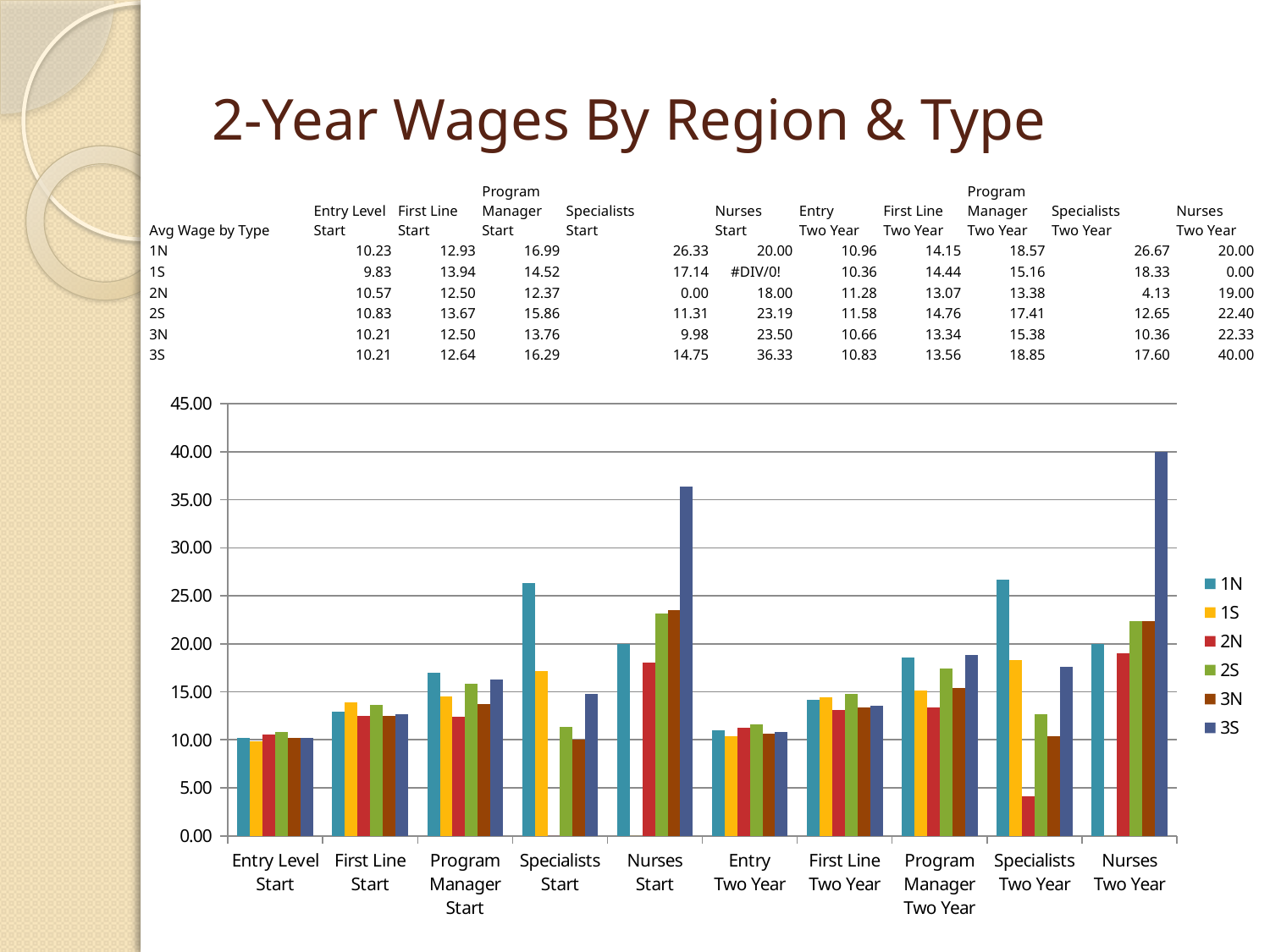
What are the entries listed in the chart's legend? 1N, 1S, 2N, 2S, 3N, 3S How many categories are shown along the x axis of the chart? 10 Which series has the highest value in the Nurses Start category? 3S What is the difference between the 3S value for Nurses Two Year and the 3S value for Nurses Start? 3.67 How many series does the chart's legend list? 6 Which series has the lowest value in the Specialists Two Year category? 2N What kind of chart is shown on the slide? bar chart What is the value for 1N in the Specialists Start category? 26.33 Which is larger in the Specialists Two Year category: the value for 1N or the value for 1S? 1N Is the value for 3S in the Nurses Start category greater or less than 35.00? greater What is the value for 2S in the Program Manager Two Year category? 17.41 What is the value for 3S in the Nurses Two Year category? 40.00